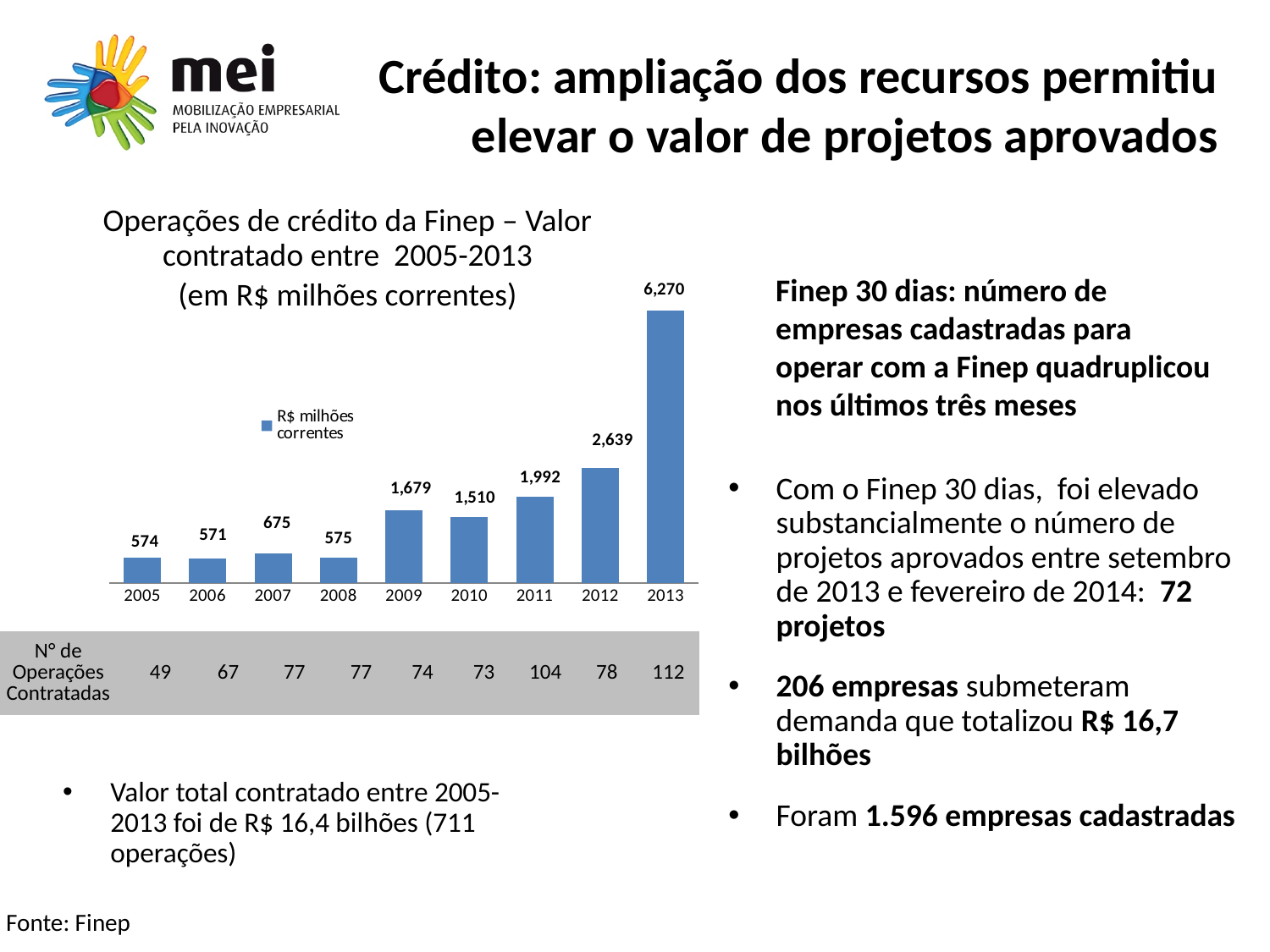
What is the value for 2006 in the chart? 571 What is the value for 2009 in the chart? 1,679 How many years are shown on the x axis of the chart? 9 How many series does the chart legend list? 1 Which year has the lowest value in the chart? 2006 What is the difference between the values for 2011 and 2010? 482 Which is larger, the value for 2009 or the value for 2010? 2009 What is the legend entry of the chart? R$ milhões correntes What is the value for 2013 in the chart? 6,270 Which year has the highest value in the chart? 2013 What is the difference between the values for 2013 and 2012? 3,631 What kind of chart is shown on the slide? Bar chart